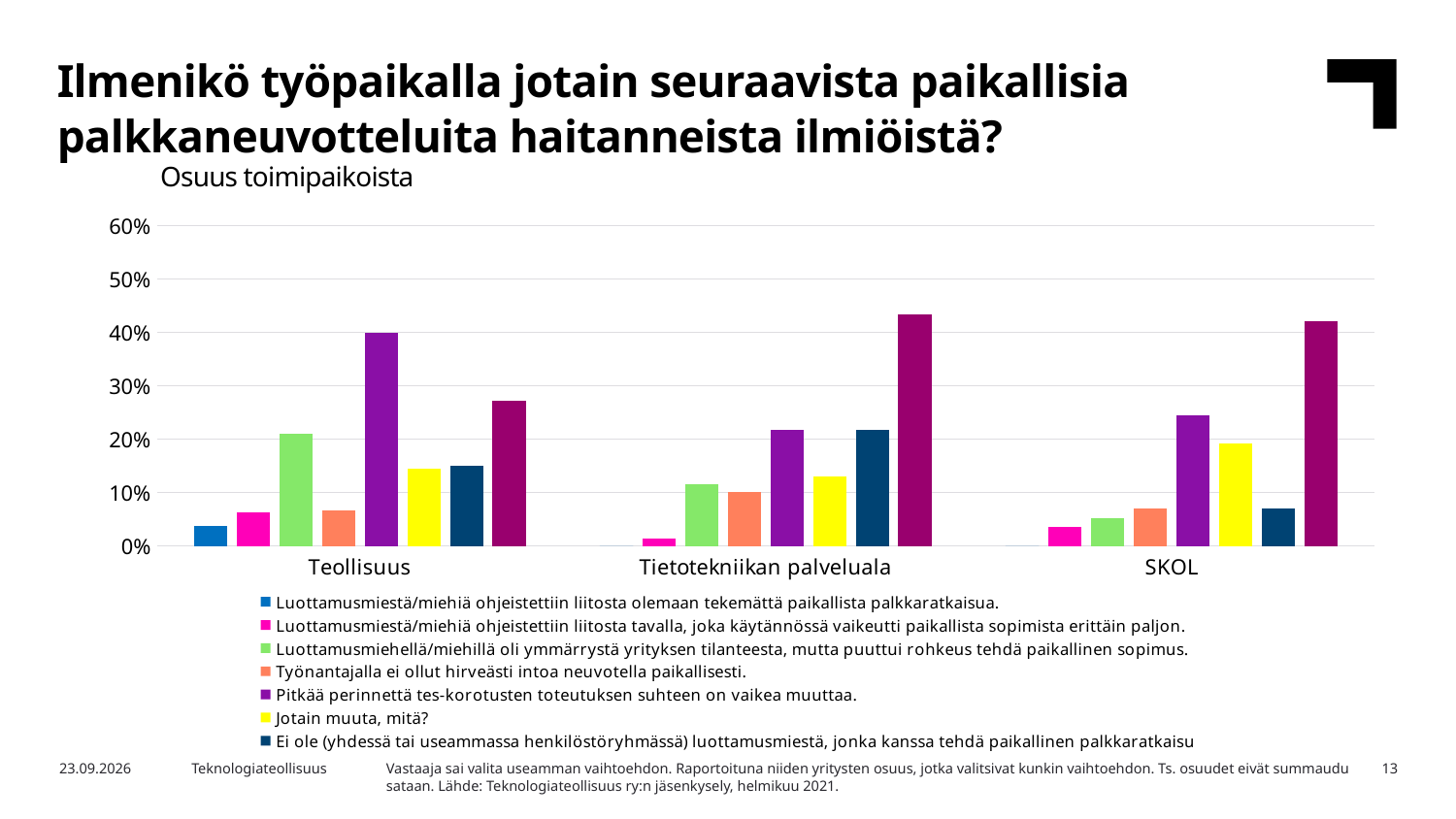
Is the value for 'Työnantajalla ei ollut hirveästi intoa neuvotella paikallisesti' in Tietotekniikan palveluala greater or less than 20%? less Which is larger: the value for 'Pitkää perinnettä tes-korotusten toteutuksen suhteen on vaikea muuttaa' in Teollisuus or in Tietotekniikan palveluala? Teollisuus Is the value for 'Luottamusmiehellä/miehillä oli ymmärrystä yrityksen tilanteesta, mutta puuttui rohkeus tehdä paikallinen sopimus' in Teollisuus greater or less than 30%? less How many categories are shown on the x axis of the chart? 3 Which is larger: the value for 'Luottamusmiehellä/miehillä oli ymmärrystä yrityksen tilanteesta, mutta puuttui rohkeus tehdä paikallinen sopimus' in Teollisuus or in SKOL? Teollisuus How many series does the chart's legend list? 7 Which is larger: the value for 'Jotain muuta, mitä?' in SKOL or in Teollisuus? SKOL Is the value for 'Ei ole (yhdessä tai useammassa henkilöstöryhmässä) luottamusmiestä, jonka kanssa tehdä paikallinen palkkaratkaisu' in Tietotekniikan palveluala greater or less than 10%? greater Among the series listed in the legend, which has the highest value in Teollisuus? Pitkää perinnettä tes-korotusten toteutuksen suhteen on vaikea muuttaa. What is the subtitle shown above the chart? Osuus toimipaikoista What kind of chart is shown on the slide? bar chart